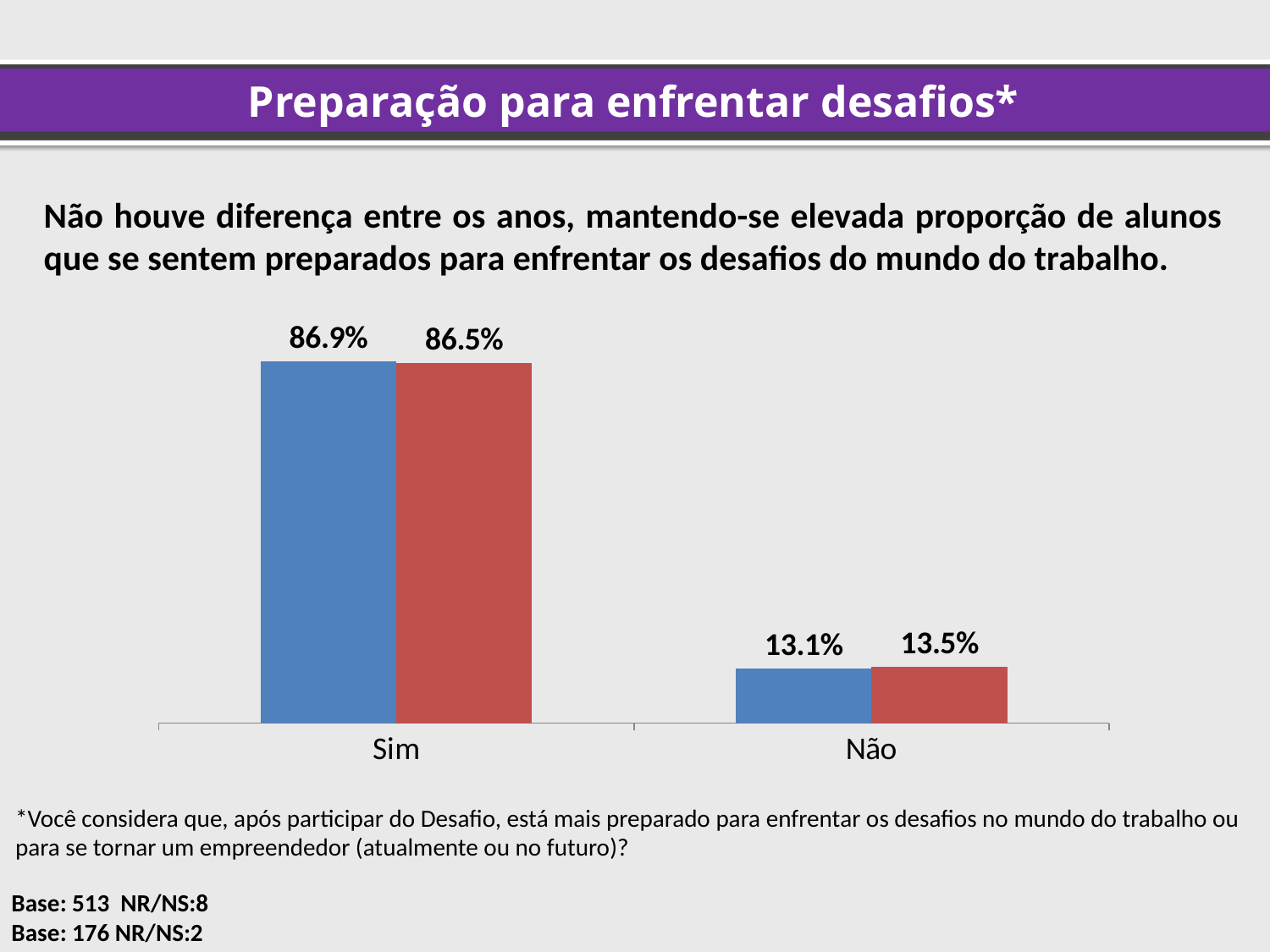
For "Não", which bar is larger, the blue one or the red one? The red one (13.5%) Which category has the highest values in the chart? Sim How many categories are shown on the x axis? 2 What is the difference between the blue bars for "Sim" and "Não"? 73.8 percentage points What is the value of the red bar for "Sim"? 86.5% What is the value of the blue bar for "Não"? 13.1% Which category has the lowest values in the chart? Não What is the title of the slide containing the chart? Preparação para enfrentar desafios* What is the value of the red bar for "Não"? 13.5% What kind of chart is shown on the slide? Bar chart What is the value of the blue bar for "Sim"? 86.9% What is the difference between the red bars for "Sim" and "Não"? 73.0 percentage points